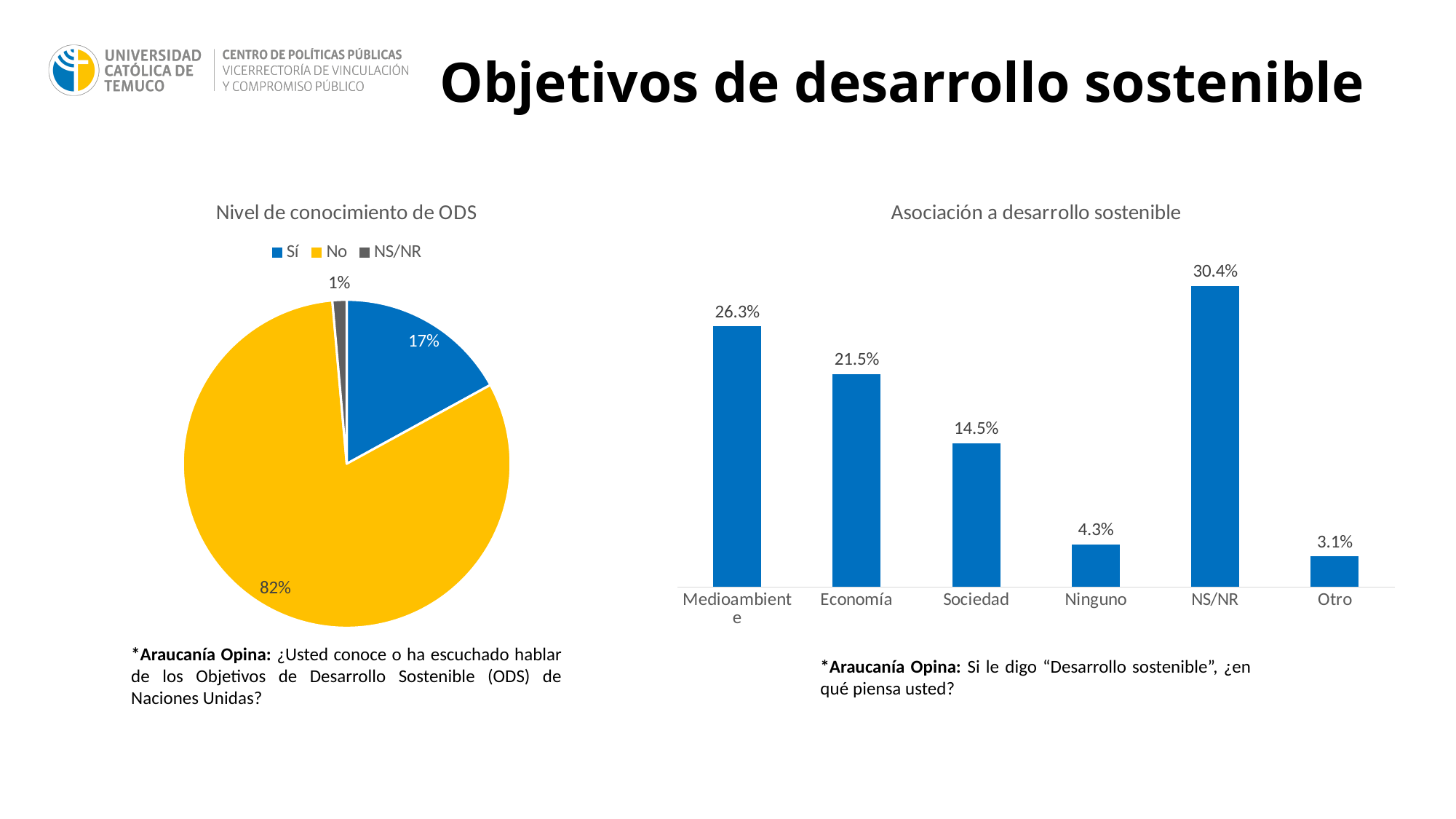
In the 'Nivel de conocimiento de ODS' chart, what percentage answered 'Sí'? 17% What kind of chart is 'Nivel de conocimiento de ODS'? Pie chart In the 'Asociación a desarrollo sostenible' chart, what is the difference between Medioambiente and Economía? 4.8% In the 'Asociación a desarrollo sostenible' chart, which category has the highest value? NS/NR In the 'Asociación a desarrollo sostenible' chart, what is the value for Economía? 21.5% In the 'Nivel de conocimiento de ODS' chart, what percentage answered 'No'? 82% In the 'Asociación a desarrollo sostenible' chart, which is larger, Ninguno or Otro? Ninguno In the 'Nivel de conocimiento de ODS' chart, which category has the smallest slice? NS/NR In the 'Asociación a desarrollo sostenible' chart, which category has the lowest value? Otro In the 'Asociación a desarrollo sostenible' chart, what is the value for Sociedad? 14.5% How many categories are shown in the 'Asociación a desarrollo sostenible' chart? 6 How many entries does the legend of the 'Nivel de conocimiento de ODS' chart list? 3